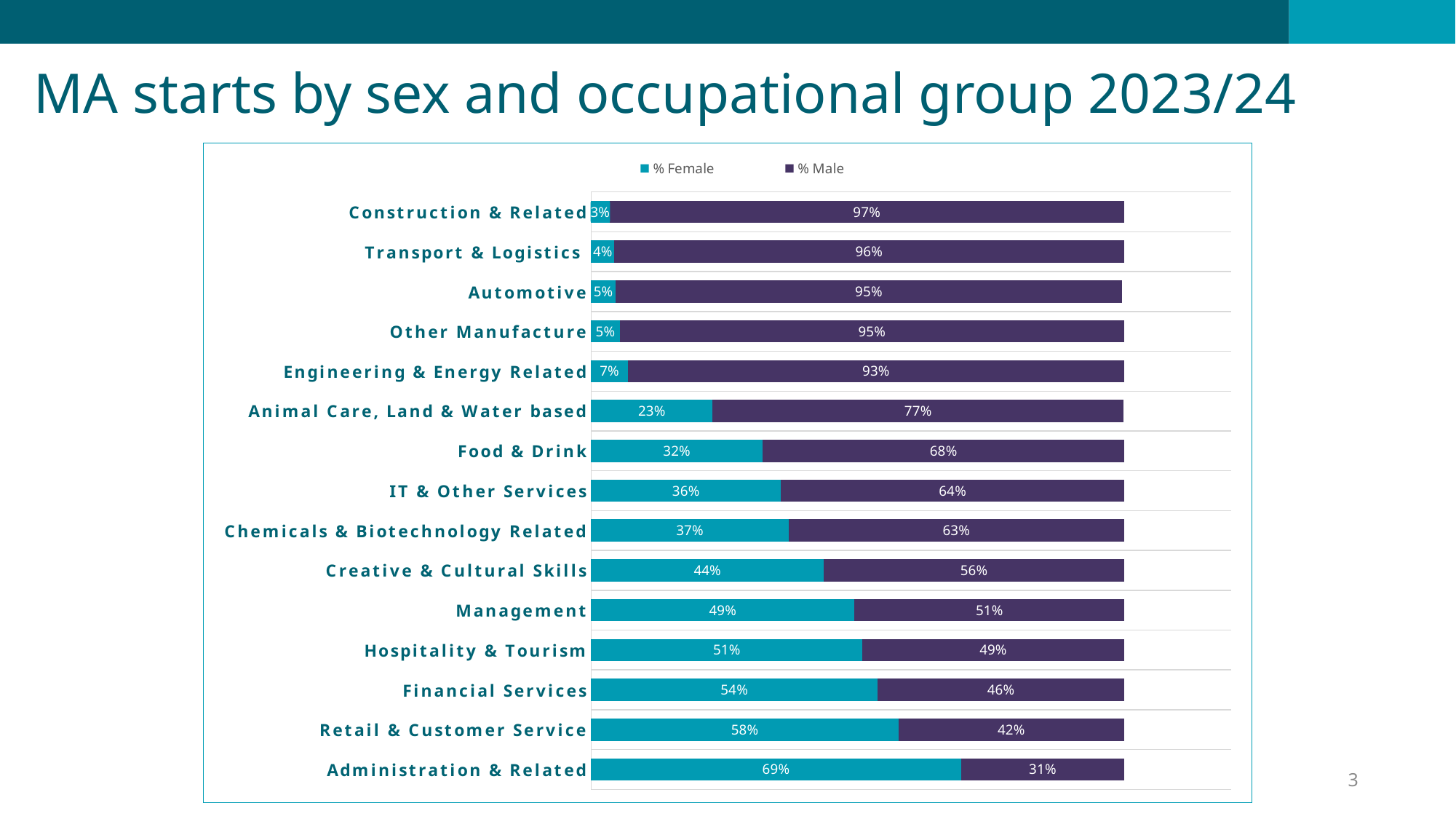
What kind of chart is shown on the slide? Stacked bar chart What is the difference between the % Female values for Retail & Customer Service and Financial Services? 4% How many occupational groups are shown in the chart? 15 Which occupational group has the highest % Male value? Construction & Related What is the % Female value for Food & Drink? 32% Which is larger, the % Female value for Creative & Cultural Skills or for Chemicals & Biotechnology Related? Creative & Cultural Skills How many series does the legend list? 2 Which occupational group has the lowest % Female value? Construction & Related What is the % Female value for Administration & Related? 69% What is the % Male value for Engineering & Energy Related? 93% Which colour represents % Male in the chart? Dark purple What is the total of the stacked bar for Management? 100%